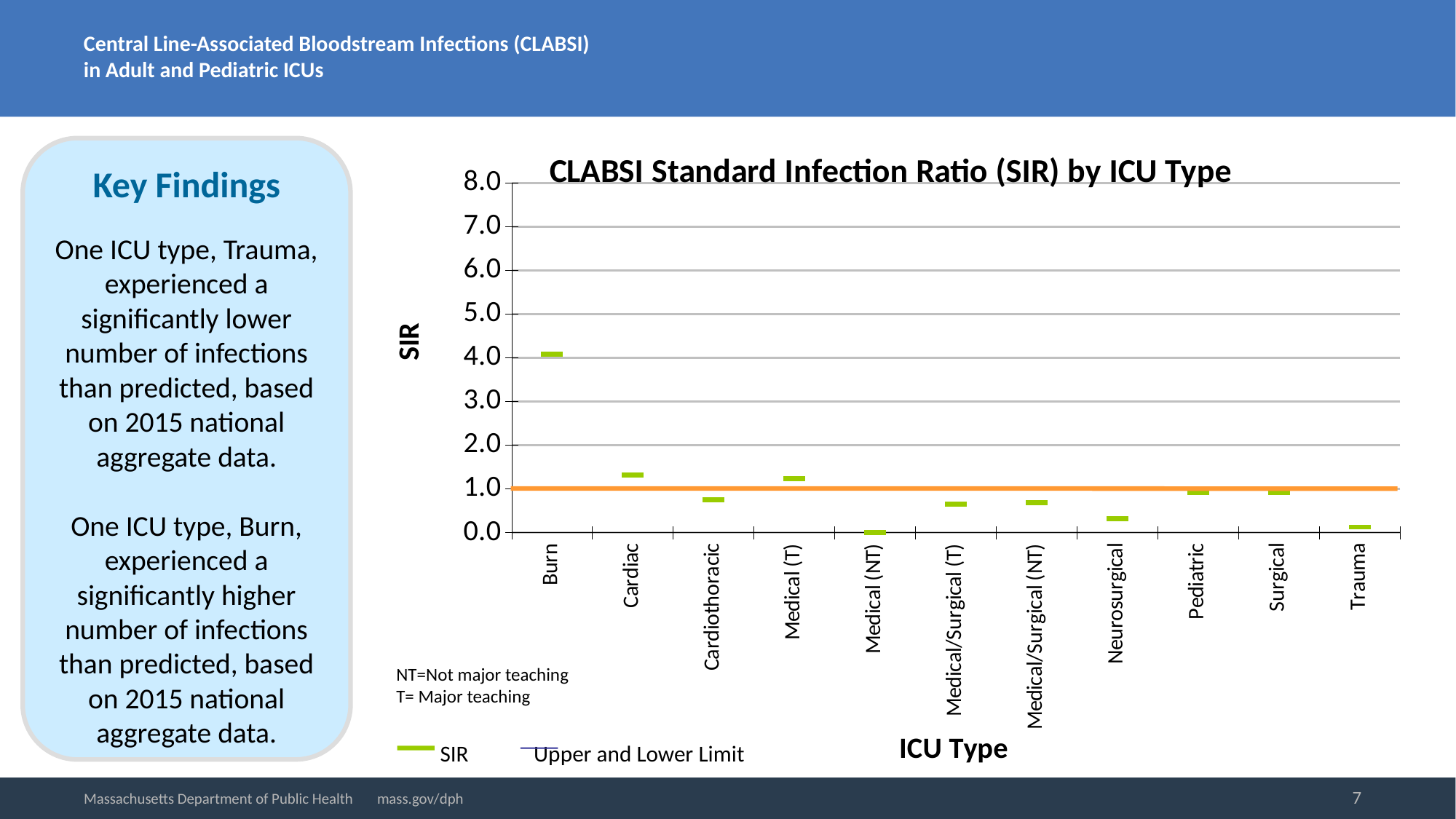
How many ICU types are shown on the x axis of the chart? 11 How many series does the chart legend list? 2 Which ICU type has the highest SIR in the chart? Burn Which has a higher SIR, Burn or Cardiac? Burn Is the SIR value for Neurosurgical greater or less than 1.0? less At what SIR value is the orange Upper and Lower Limit line drawn? 1.0 Which has a higher SIR, Cardiac or Neurosurgical? Cardiac Is the SIR value for Burn greater or less than 3.0? greater What is the title of the chart? CLABSI Standard Infection Ratio (SIR) by ICU Type What label is shown on the y axis of the chart? SIR Is the SIR value for Medical (T) greater or less than 1.0? greater